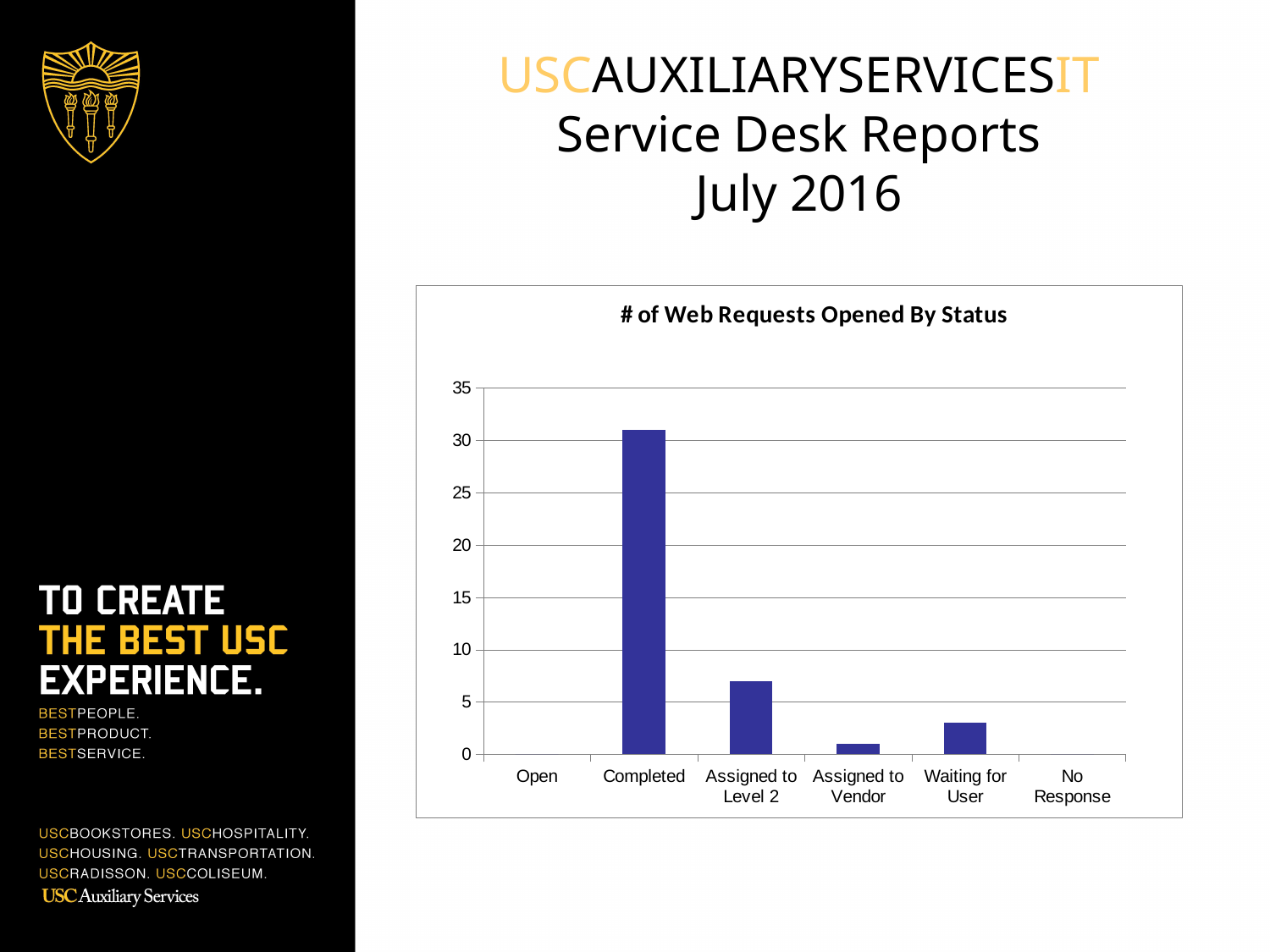
Is the value for Assigned to Level 2 greater or less than 10? less Which is larger, the value for Completed or the value for Assigned to Level 2? Completed Is the value for Waiting for User greater or less than 5? less Is the value for Assigned to Vendor greater or less than 5? less What kind of chart is shown on the slide? bar chart Which is larger, the value for Waiting for User or the value for Assigned to Vendor? Waiting for User How many status categories are shown on the x axis of the chart? 6 What is the highest value shown on the y axis of the chart? 35 Which status has the highest number of web requests opened? Completed What is the title of the chart? # of Web Requests Opened By Status